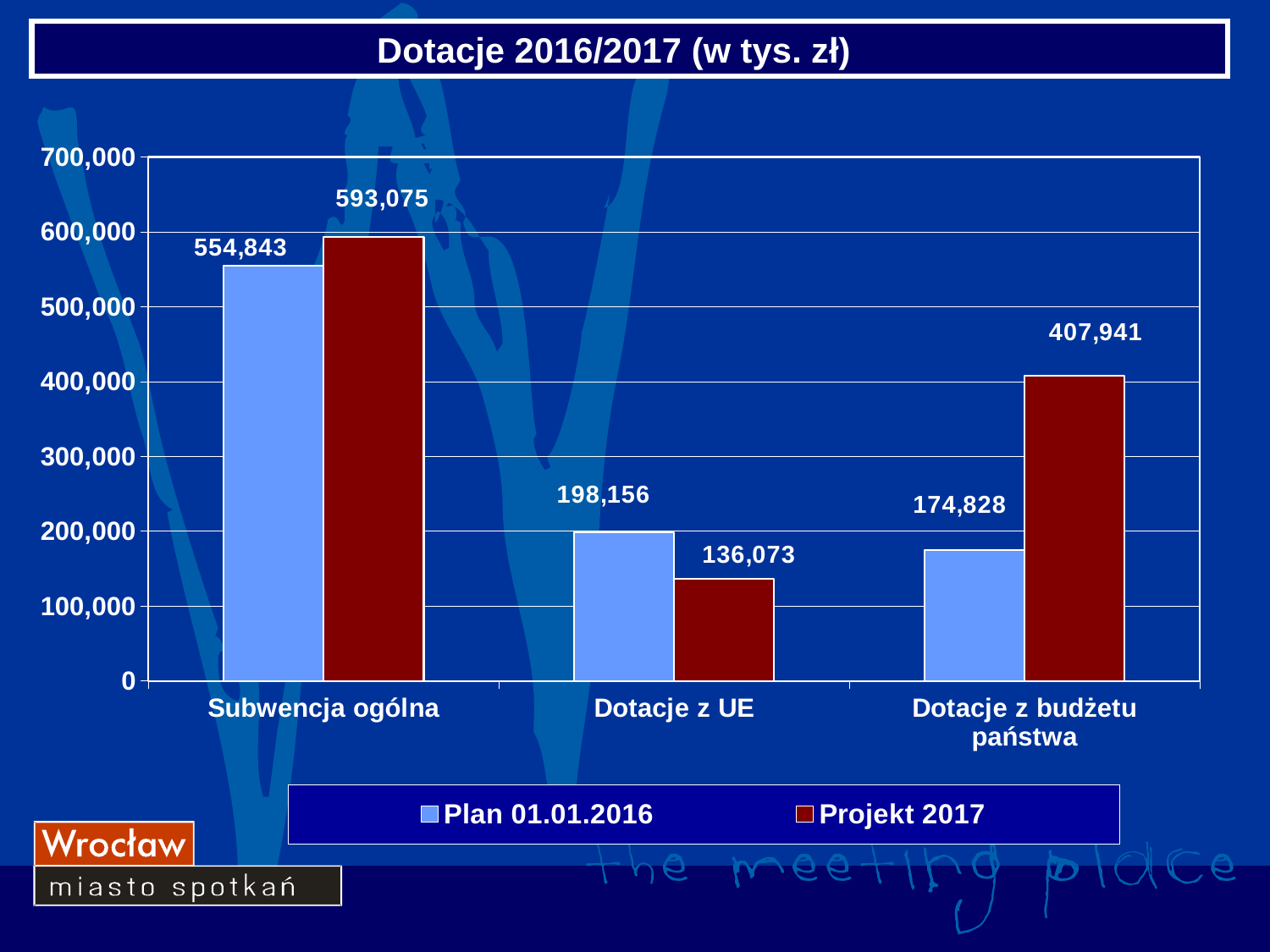
Which category has the lowest value in the Plan 01.01.2016 series? Dotacje z budżetu państwa How many series does the legend list? 2 What is the title of the chart? Dotacje 2016/2017 (w tys. zł) How many categories are shown on the x axis? 3 What is the difference between the Plan 01.01.2016 and Projekt 2017 values for Dotacje z UE? 62,083 What is the difference between the Projekt 2017 and Plan 01.01.2016 values for Dotacje z budżetu państwa? 233,113 What is the value for Dotacje z UE in the Projekt 2017 series? 136,073 What kind of chart is shown on the slide? Bar chart What is the value for Dotacje z budżetu państwa in the Projekt 2017 series? 407,941 For Dotacje z UE, which series has the larger value: Plan 01.01.2016 or Projekt 2017? Plan 01.01.2016 Which category has the highest value in the Projekt 2017 series? Subwencja ogólna What is the value for Subwencja ogólna in the Plan 01.01.2016 series? 554,843